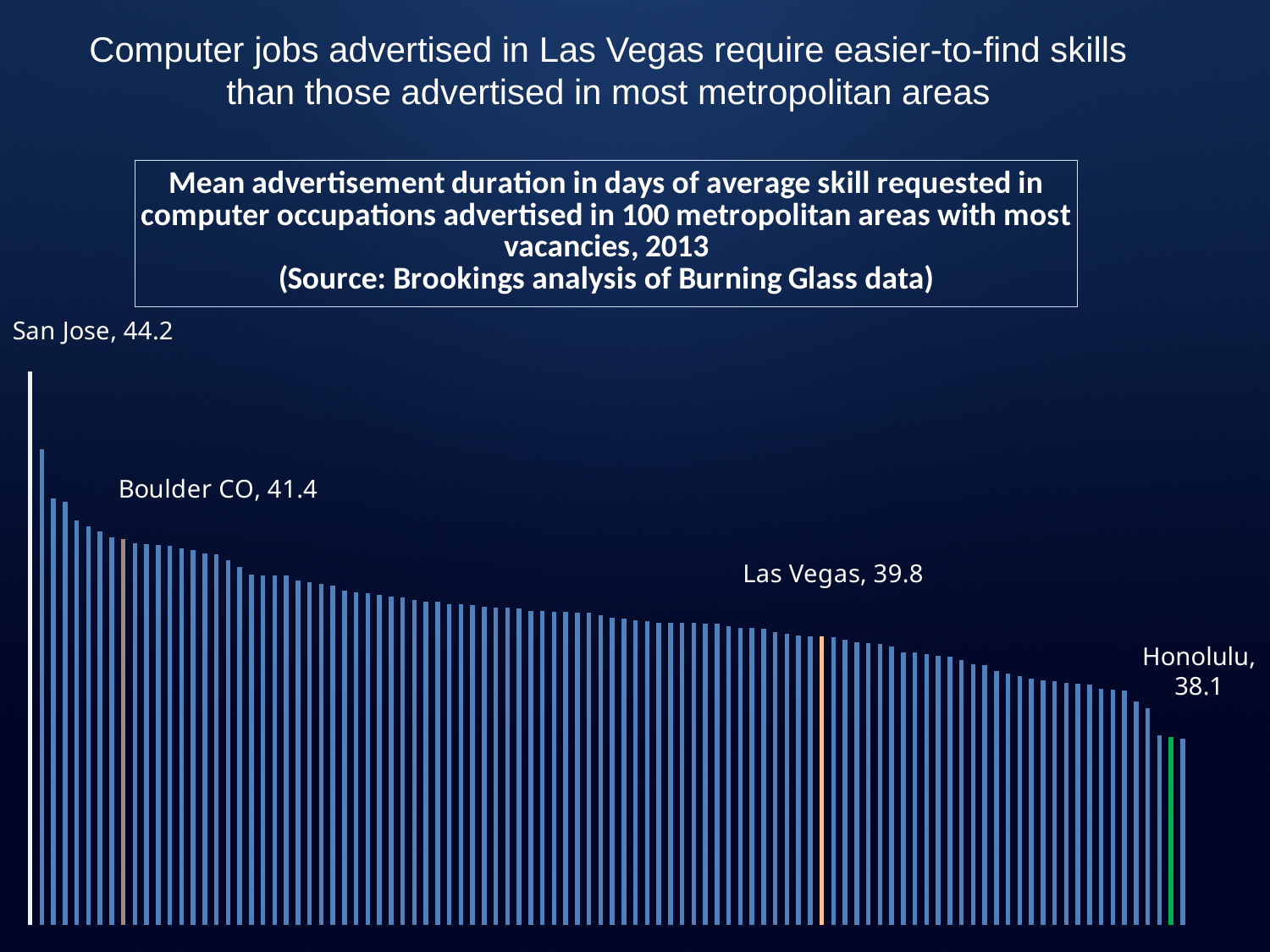
What is the difference between the values for San Jose and Las Vegas? 4.4 What value is labeled for Las Vegas on the chart? 39.8 What value is labeled for Boulder CO? 41.4 Do the bar values rise or fall from left to right across the chart? Fall What kind of chart is shown on the slide? Bar chart Which has a larger value, Las Vegas or Honolulu? Las Vegas Which has a larger value, Boulder CO or Las Vegas? Boulder CO What value is labeled for Honolulu? 38.1 How many metropolitan areas are plotted on the chart? 100 Which metropolitan area has the highest value on the chart? San Jose What is the difference between the values for Boulder CO and Honolulu? 3.3 What is the mean advertisement duration value shown for San Jose? 44.2